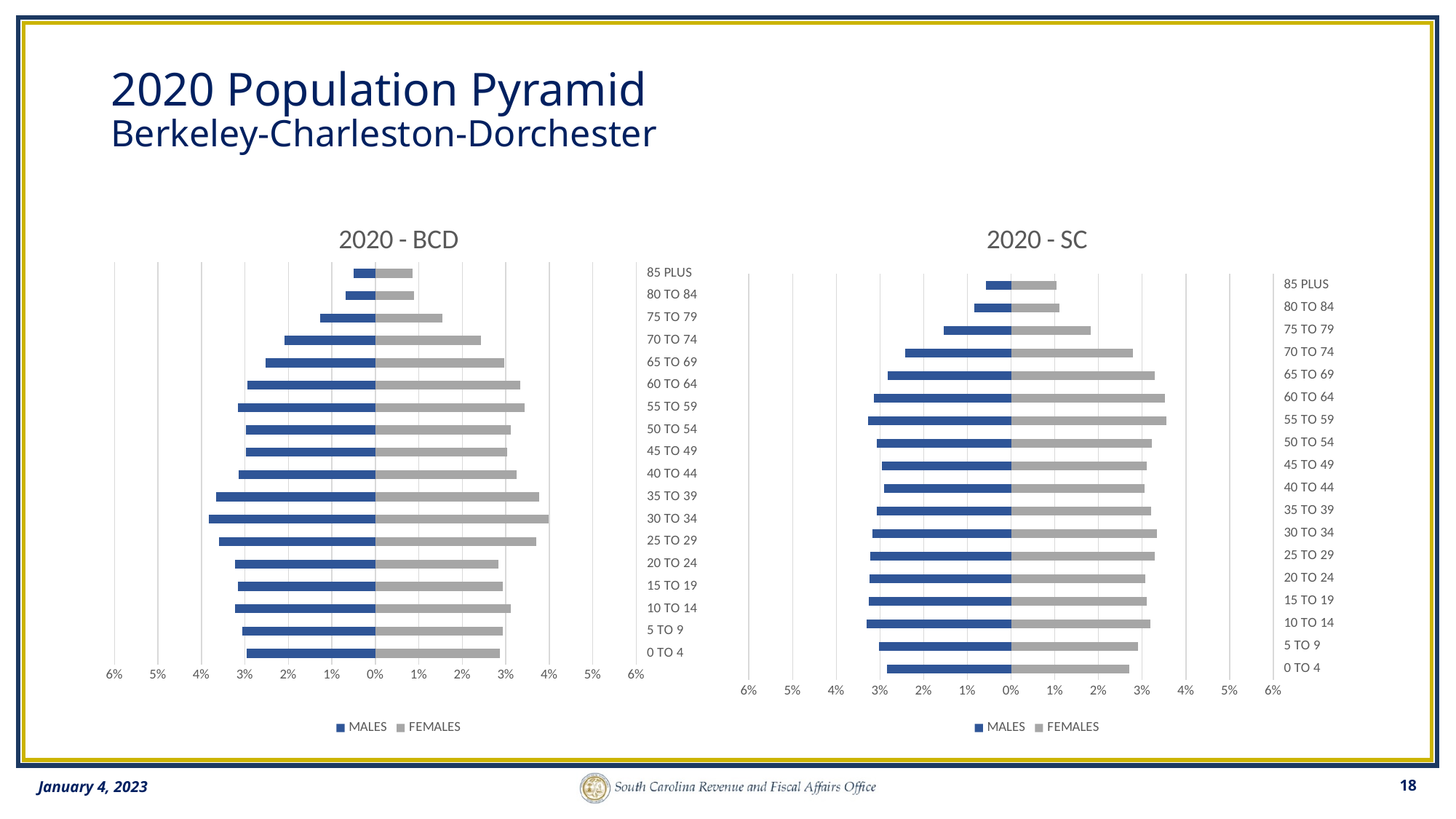
In the "2020 - SC" chart, which colour represents the FEMALES series? gray In the "2020 - BCD" chart, is the MALES value for 85 PLUS greater or less than 1%? less How many series does the legend of the "2020 - BCD" chart list? 2 In the "2020 - BCD" chart, which age group has the longest MALES bar? 30 TO 34 In the "2020 - BCD" chart, which is larger, the MALES bar for 30 TO 34 or the MALES bar for 0 TO 4? 30 TO 34 In the "2020 - SC" chart, is the MALES value for 0 TO 4 greater or less than 3%? less In the "2020 - BCD" chart, which age group has the longest FEMALES bar? 30 TO 34 In the "2020 - BCD" chart, which age group has the shortest MALES bar? 85 PLUS In the "2020 - BCD" chart, is the FEMALES value for 30 TO 34 greater or less than 3%? greater What kind of chart is the "2020 - BCD" chart? bar chart How many age-group categories does the "2020 - SC" chart show? 18